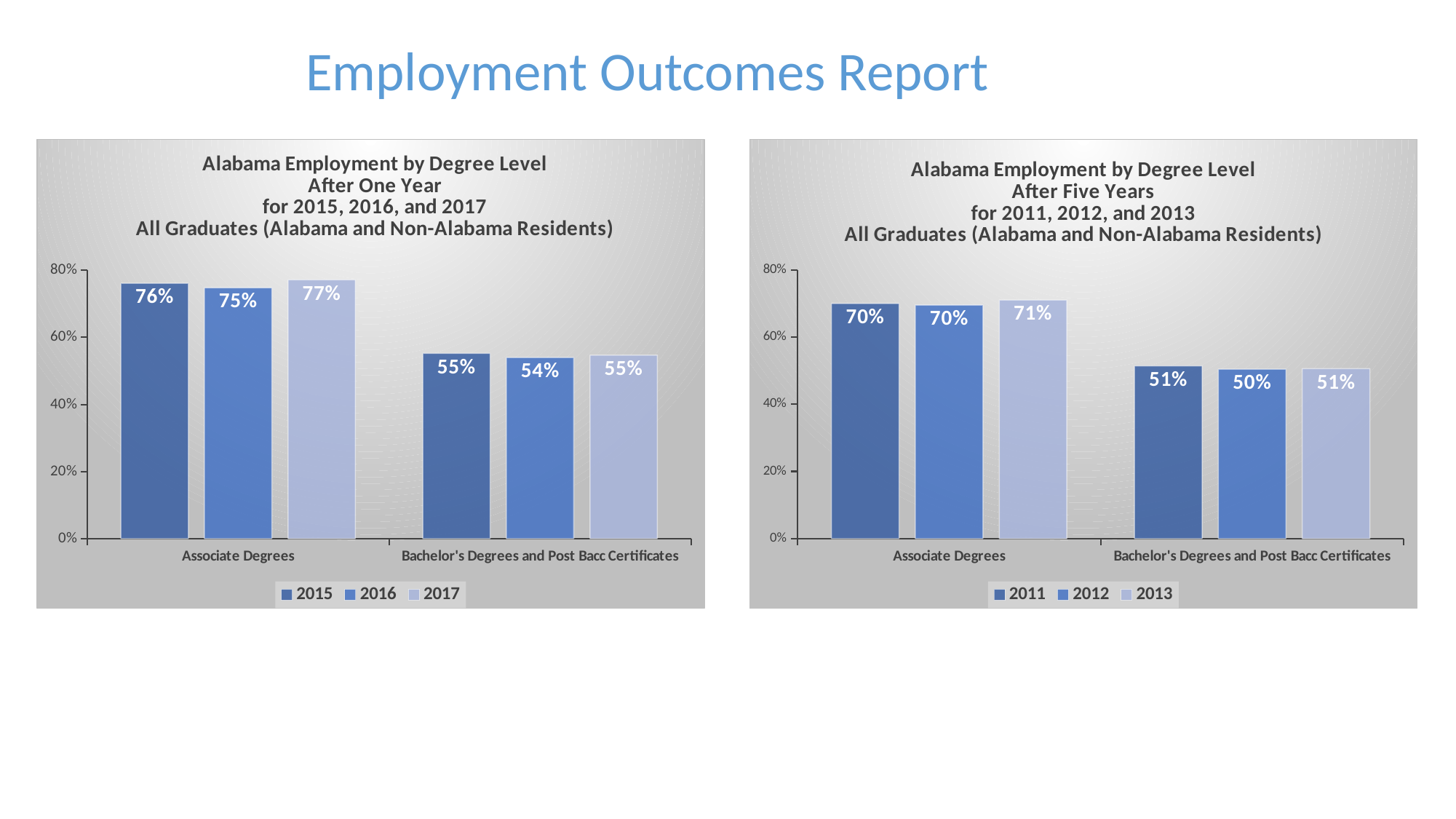
Which years are listed in the legend of the right chart (After Five Years)? 2011, 2012, 2013 In the left chart (After One Year), what is the value for Associate Degrees in 2017? 77% In the right chart (After Five Years), is the value for Bachelor's Degrees and Post Bacc Certificates in 2013 greater or less than 60%? less In the right chart (After Five Years), what is the value for Bachelor's Degrees and Post Bacc Certificates in 2012? 50% In the right chart (After Five Years), what is the difference between the 2011 values for Associate Degrees and Bachelor's Degrees and Post Bacc Certificates? 19% How many series does the legend of the left chart (After One Year) list? 3 In the left chart (After One Year), what is the value for Bachelor's Degrees and Post Bacc Certificates in 2016? 54% In the right chart (After Five Years), what is the value for Associate Degrees in 2013? 71% How many categories are shown on the x axis of the right chart (After Five Years)? 2 In the left chart (After One Year), which category has the higher value in 2016: Associate Degrees or Bachelor's Degrees and Post Bacc Certificates? Associate Degrees In the left chart (After One Year), what is the difference between the 2015 values for Associate Degrees and Bachelor's Degrees and Post Bacc Certificates? 21% What kind of chart is the left chart (After One Year)? Bar chart